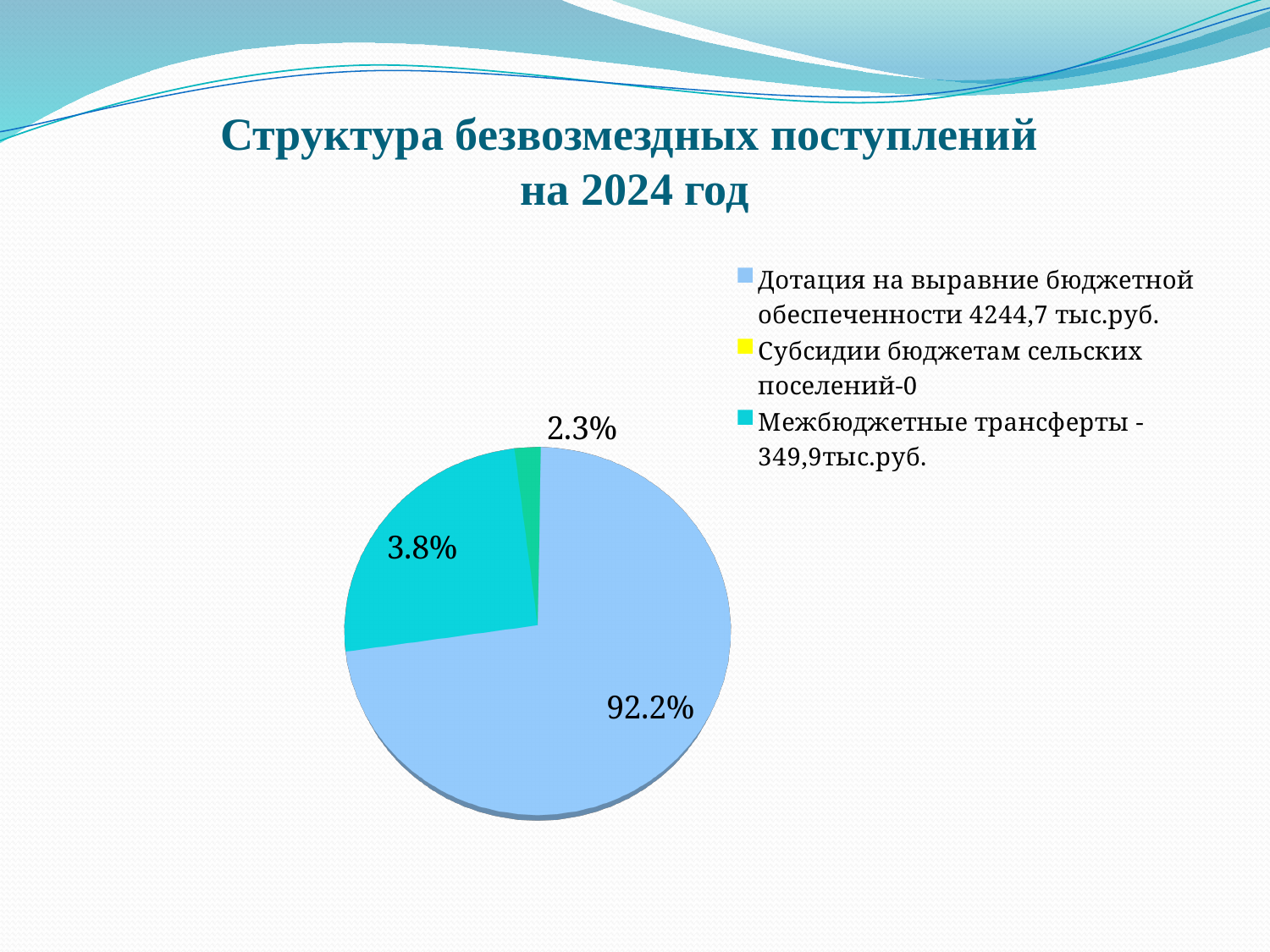
What is the title of the chart on the slide? Структура безвозмездных поступлений на 2024 год What is the share of the largest slice of the pie chart? 92.2% How many entries does the legend list? 3 What is the difference in percentage points between the 3.8% slice and the 2.3% slice? 1.5 What kind of chart is shown on the slide? pie chart How many slices does the pie chart have? 3 According to the legend, what amount is given for Межбюджетные трансферты? 349,9 тыс.руб. What is the difference in percentage points between the 92.2% slice and the 3.8% slice? 88.4 What share of the pie does the light blue slice (Дотация на выравнивание бюджетной обеспеченности) take? 92.2% Is the share of the largest slice greater or less than 90%? greater What is the share of the smallest slice of the pie chart? 2.3% Which is larger, the teal slice labelled 3.8% or the green slice labelled 2.3%? the teal slice (3.8%)